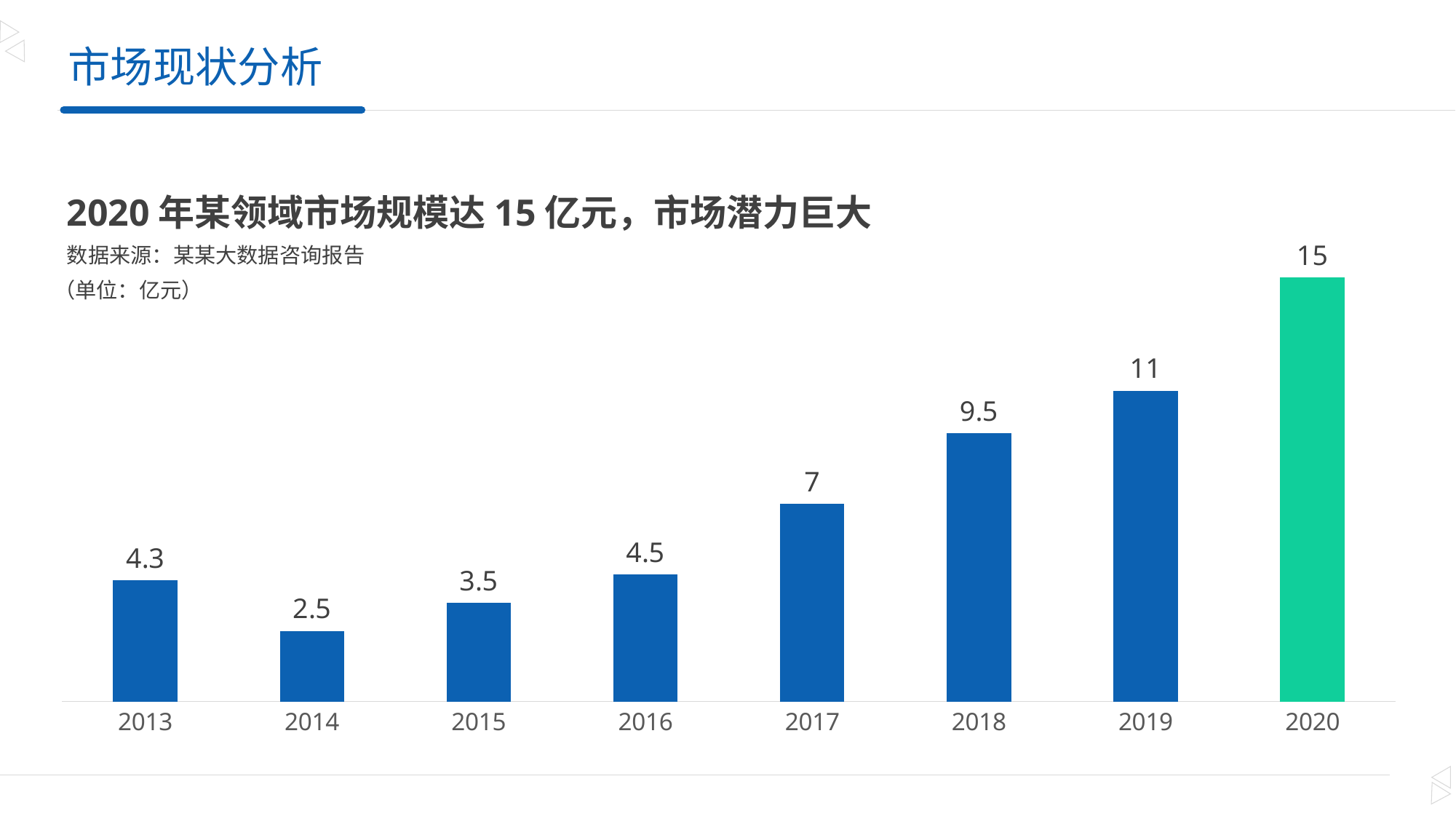
Which is larger, the value for 2013 or the value for 2015? 2013 What is the difference between the values for 2013 and 2014? 1.8 Do the values generally rise or fall from 2014 to 2020? rise What kind of chart is shown on the slide? bar chart What is the value for 2018? 9.5 What is the difference between the values for 2020 and 2019? 4 What is the value for 2017? 7 Which year has the lowest value? 2014 How many years are shown on the x axis? 8 Which year has the highest value? 2020 Which bar is shown in a different colour (green) from the others? 2020 What is the value for 2014? 2.5